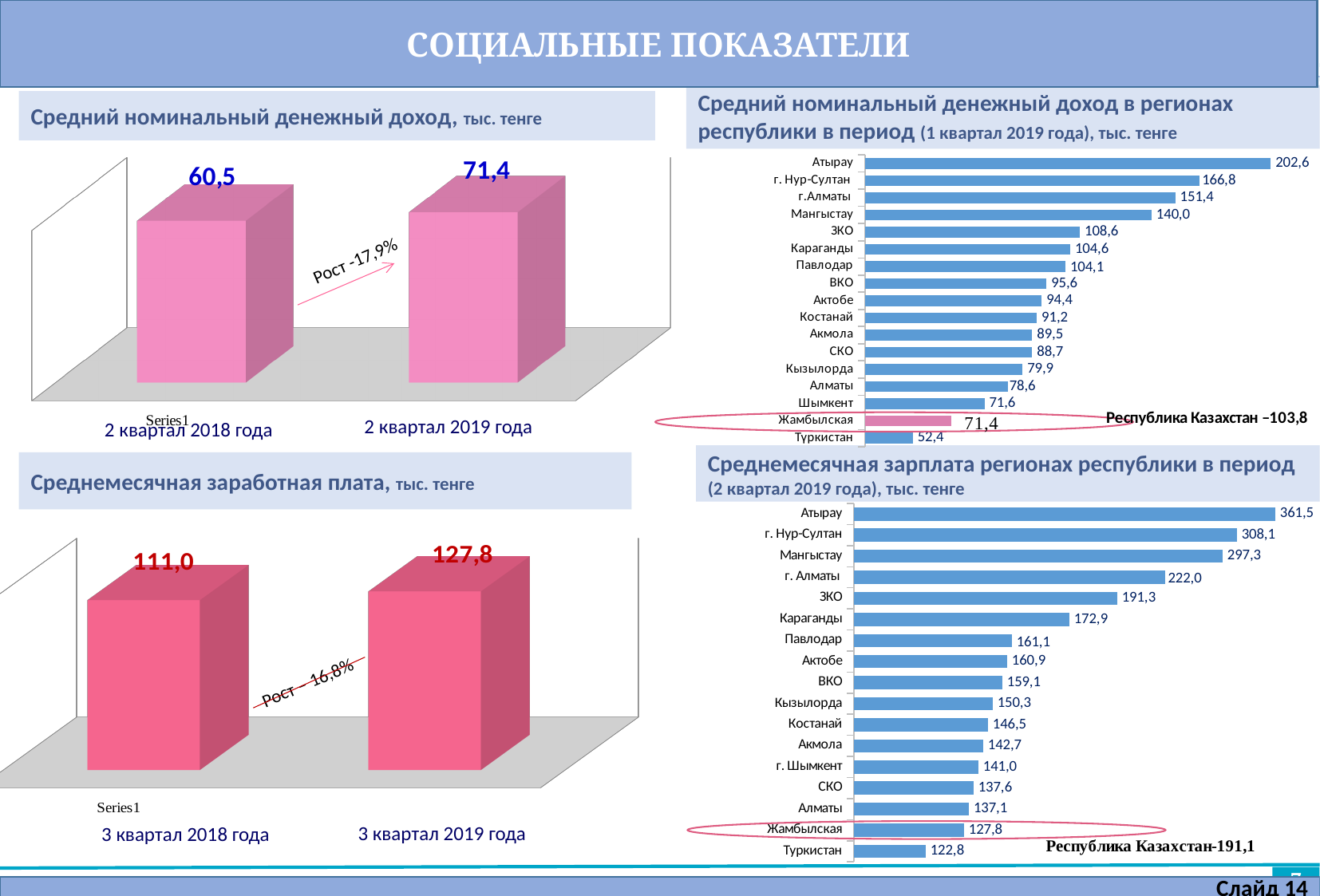
In the top-left chart 'Средний номинальный денежный доход', what is the value for 2 квартал 2019 года? 71,4 In the bottom-right chart of average monthly salary by region (2 квартал 2019 года), what is the difference between Атырау and г. Нур-Султан? 53,4 In the top-right chart of average nominal income by region (1 квартал 2019 года), which region has the highest value? Атырау What type of chart is the bottom-right chart of average monthly salary by region? bar chart In the bottom-right chart of average monthly salary by region (2 квартал 2019 года), which is larger: Павлодар or Актобе? Павлодар In the bottom-left chart 'Среднемесячная заработная плата', what is the value for 3 квартал 2018 года? 111,0 In the top-right chart of average nominal income by region (1 квартал 2019 года), which region has the lowest value? Түркистан In the bottom-right chart of average monthly salary by region (2 квартал 2019 года), what is the value for Жамбылская? 127,8 In the top-right chart of average nominal income by region (1 квартал 2019 года), how many regions are listed? 17 In the top-left chart 'Средний номинальный денежный доход', what is the difference between the 2 квартал 2019 года and 2 квартал 2018 года values? 10,9 In the top-right chart of average nominal income by region (1 квартал 2019 года), what is the value for Мангыстау? 140,0 In the bottom-left chart 'Среднемесячная заработная плата', do the values rise or fall from 3 квартал 2018 года to 3 квартал 2019 года? rise